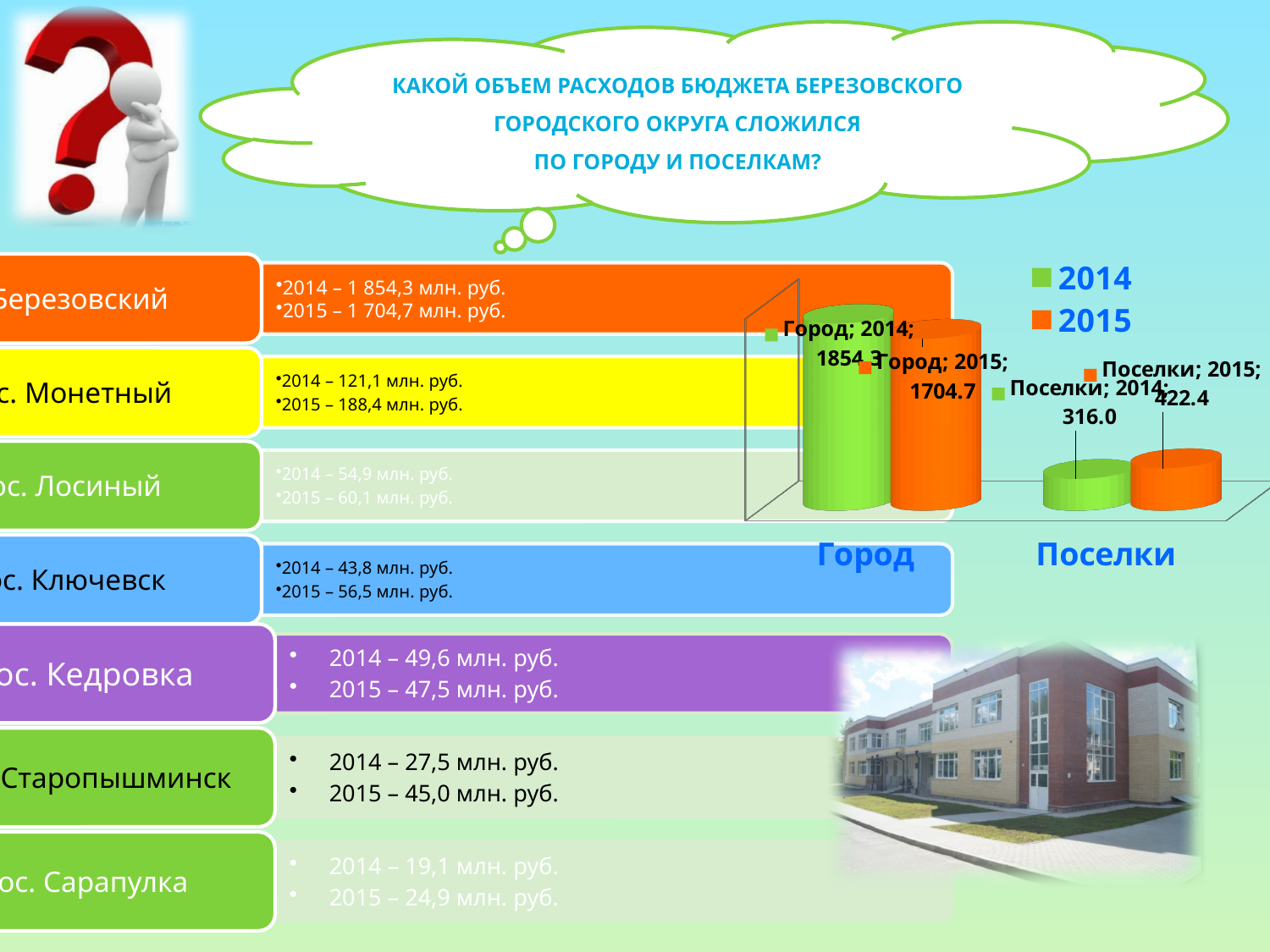
What is the difference between the 2014 and 2015 values for Город? 149.6 What is the value for Город in 2014? 1854.3 Which category has the lowest value in the 2015 series? Поселки How many categories are shown on the chart's x axis? 2 What is the value for Поселки in 2014? 316.0 How many series does the chart legend list? 2 What is the value for Город in 2015? 1704.7 What kind of chart is shown on the slide? Bar chart Which category has the highest value in the 2014 series? Город What is the difference between the 2015 and 2014 values for Поселки? 106.4 What is the value for Поселки in 2015? 422.4 Which is larger for Поселки: the 2014 value or the 2015 value? 2015